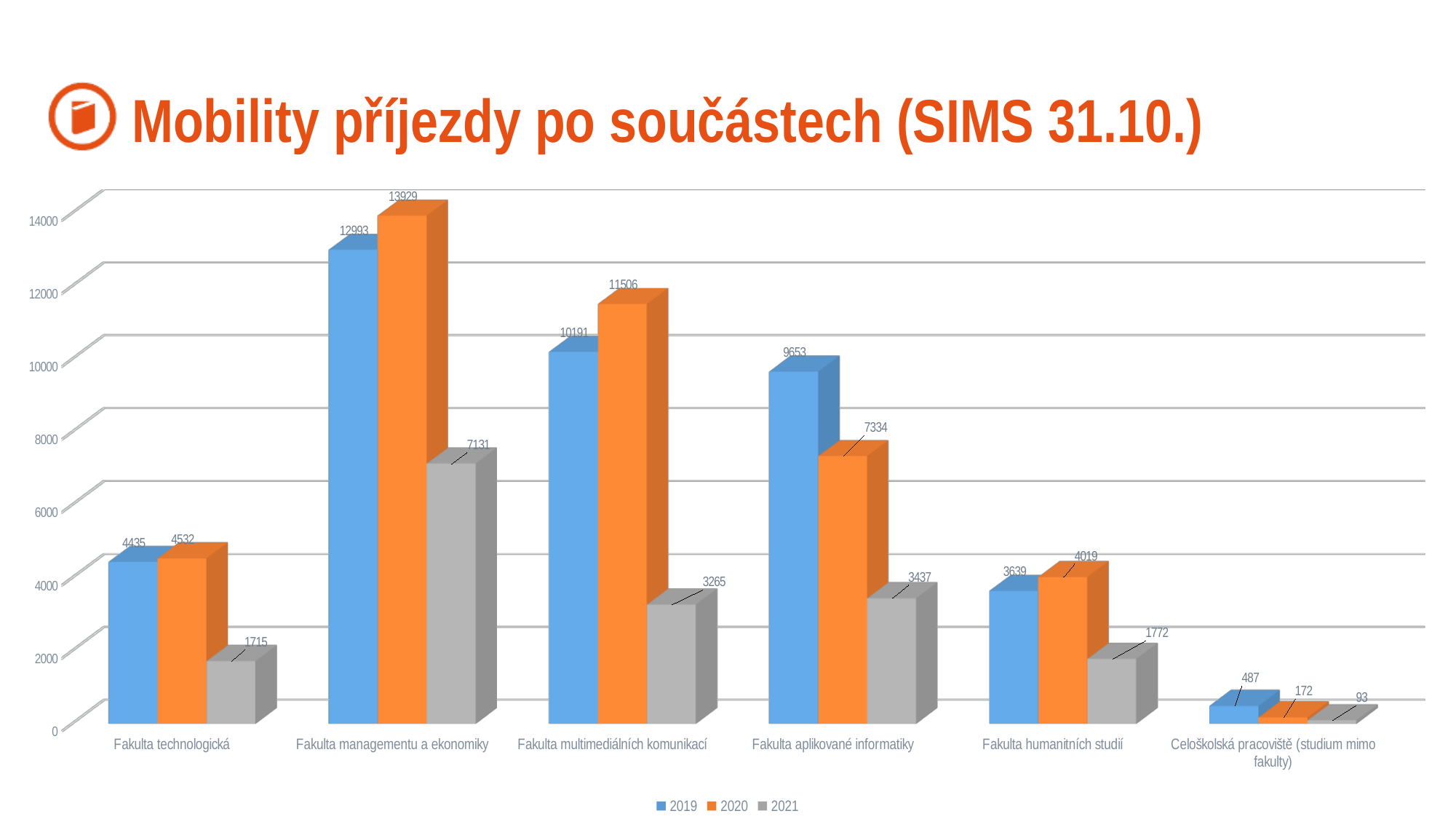
What is the 2019 value for Fakulta aplikované informatiky? 9653 How many series does the legend list? 3 What kind of chart is shown on the slide? bar chart For Fakulta aplikované informatiky, which is larger: the 2019 value or the 2020 value? 2019 What is the difference between the 2020 and 2019 values for Fakulta technologická? 97 What is the 2020 value for Fakulta managementu a ekonomiky? 13929 What is the 2021 value for Fakulta multimediálních komunikací? 3265 Which category has the highest 2020 value? Fakulta managementu a ekonomiky What is the title of the chart on the slide? Mobility příjezdy po součástech (SIMS 31.10.) How many categories are shown on the x axis? 6 Which category has the lowest 2021 value? Celoškolská pracoviště (studium mimo fakulty) Is the 2021 value for Fakulta managementu a ekonomiky greater or less than 6000? greater